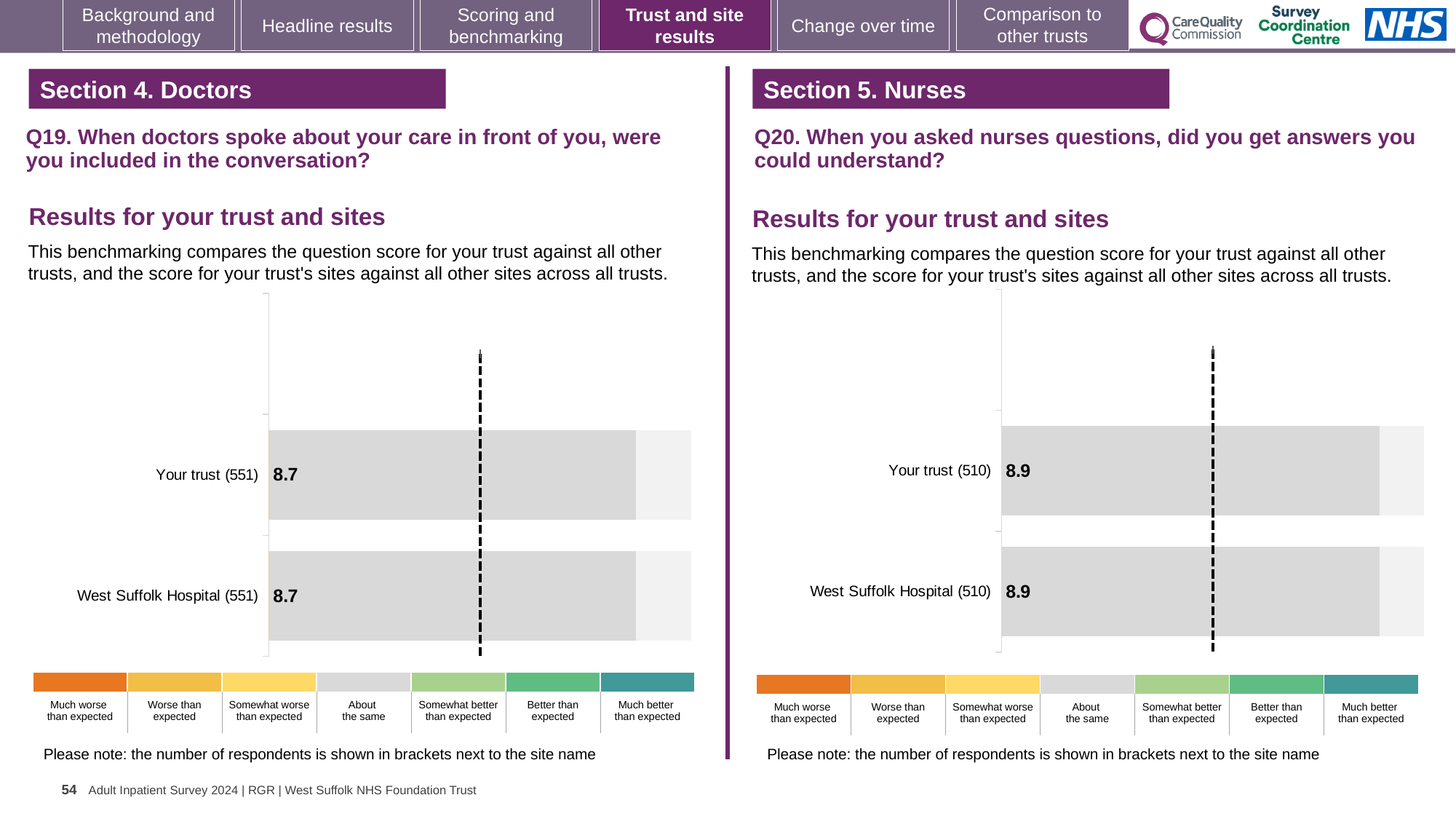
In the Q19 chart on the left, what is the score for West Suffolk Hospital? 8.7 What kind of chart is used for the Q19 results on the left? Bar chart How many bars are plotted in the Q19 chart on the left? 2 In the Q20 chart on the right, how many respondents are shown in brackets next to West Suffolk Hospital? 510 In the Q20 chart on the right, what is the score for Your trust? 8.9 In the Q19 chart on the left, what is the difference between the score for Your trust and the score for West Suffolk Hospital? 0.0 In the Q20 chart on the right, what is the score for West Suffolk Hospital? 8.9 In the Q19 chart on the left, what is the score for Your trust? 8.7 How many bars are plotted in the Q20 chart on the right? 2 In the Q19 chart on the left, how many respondents are shown in brackets next to Your trust? 551 In the Q20 chart on the right, what is the difference between the score for Your trust and the score for West Suffolk Hospital? 0.0 Is the score for Your trust in the Q20 chart on the right larger or smaller than the score for Your trust in the Q19 chart on the left? Larger